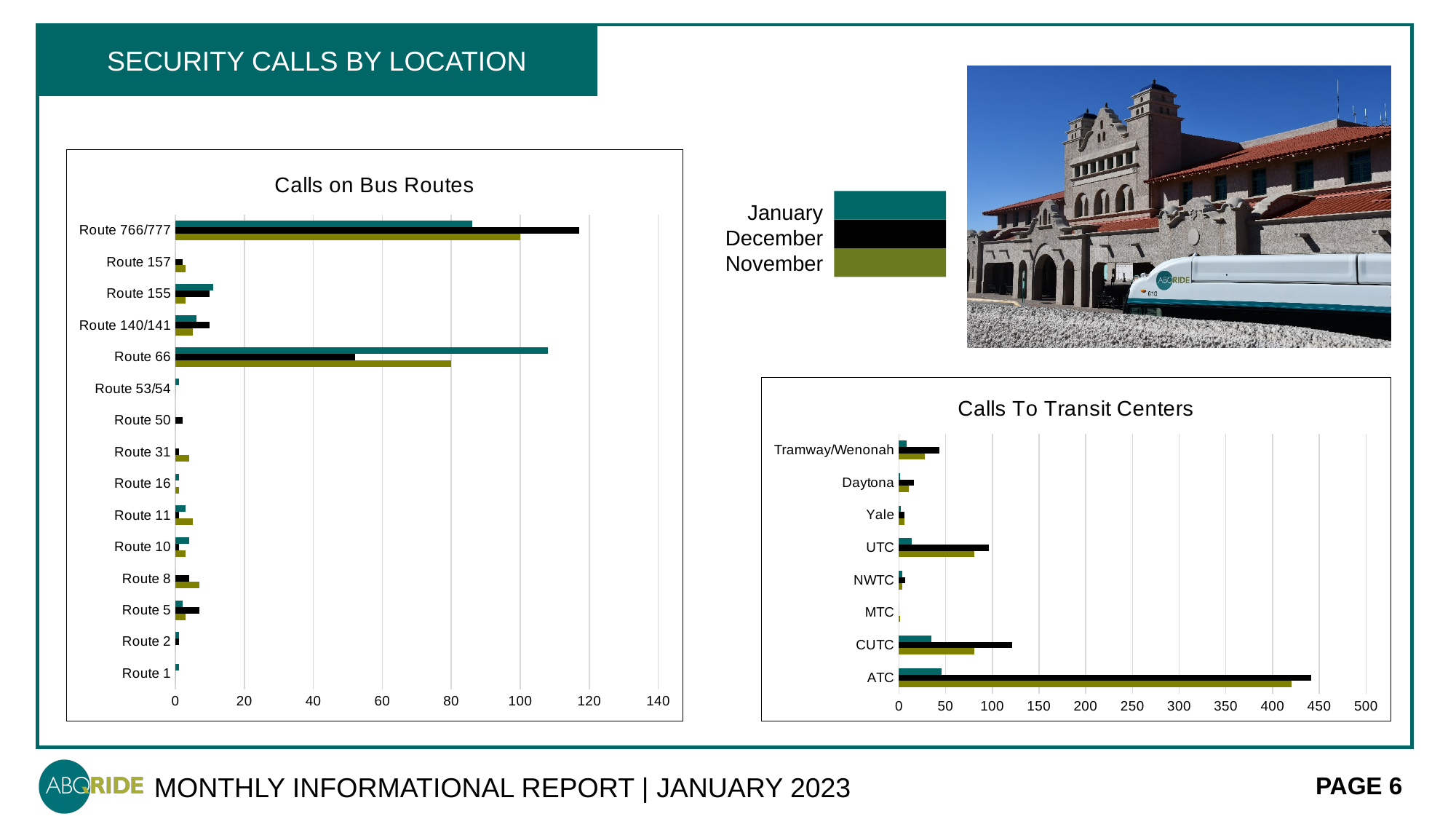
What kind of chart is the "Calls on Bus Routes" chart? bar chart In the "Calls on Bus Routes" chart, is the December value for Route 766/777 greater or less than 100? greater In the "Calls To Transit Centers" chart, is the November value for UTC greater or less than 100? less In the "Calls on Bus Routes" chart, is the December value for Route 66 greater or less than 60? less How many series does the legend list for the charts on this slide? 3 In the "Calls on Bus Routes" chart, which is larger: the January value for Route 66 or the January value for Route 766/777? Route 66 In the "Calls on Bus Routes" chart, how many routes are shown? 15 In the "Calls To Transit Centers" chart, how many transit centers are shown? 8 In the "Calls To Transit Centers" chart, which transit center has the highest December value? ATC In the "Calls on Bus Routes" chart, which route has the highest December value? Route 766/777 In the "Calls on Bus Routes" chart, which route has the highest January value? Route 66